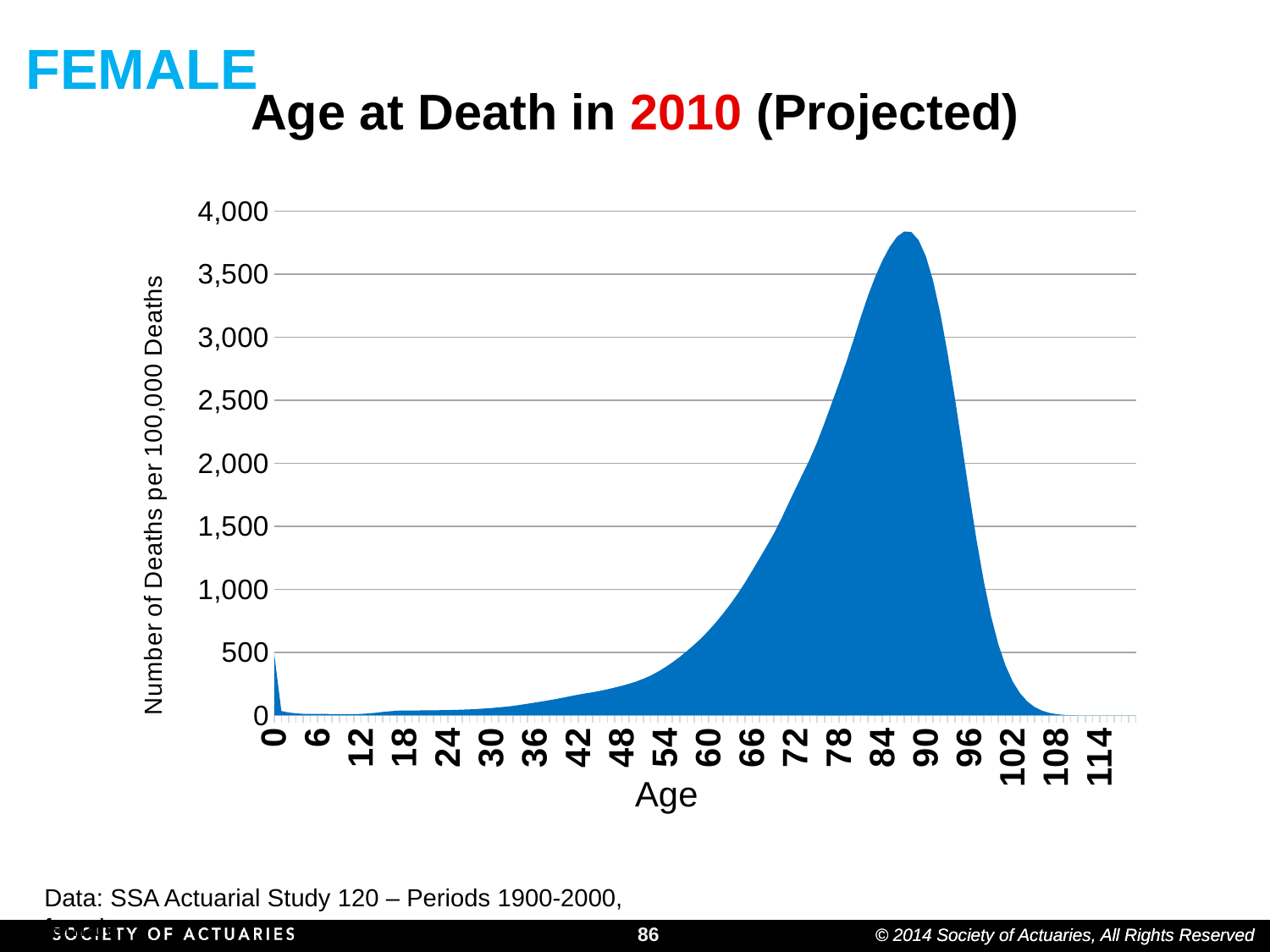
Is the value at age 102 greater or less than 500? less Which is larger, the value at age 84 or the value at age 60? age 84 Is the peak value of the curve greater or less than 4,000? less What kind of chart is shown on the slide? area chart What is the title of the chart? Age at Death in 2010 (Projected) Is the value at age 60 greater or less than 1,000? less What is the label of the vertical axis? Number of Deaths per 100,000 Deaths Which is larger, the value at age 78 or the value at age 102? age 78 Do the values rise or fall as age increases from 60 to 84? rise